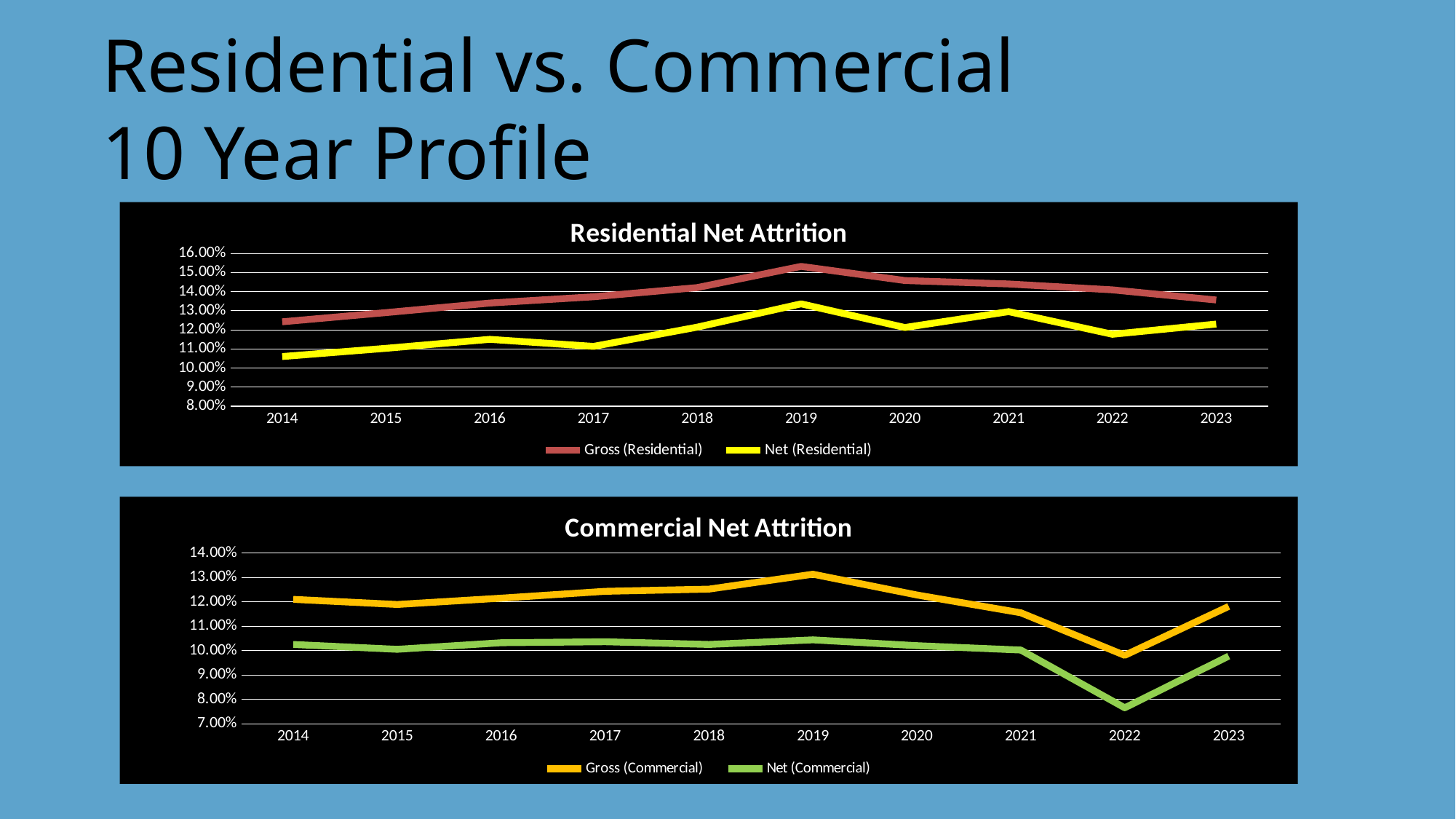
In the Commercial Net Attrition chart, which series is higher in 2021, Gross (Commercial) or Net (Commercial)? Gross (Commercial) How many years are plotted on the x axis of the Residential Net Attrition chart? 10 How many series does the legend of the Commercial Net Attrition chart list? 2 In the Commercial Net Attrition chart, in which year is Net (Commercial) lowest? 2022 In the Residential Net Attrition chart, is the Gross (Residential) value for 2019 greater or less than 15.00%? greater In the Residential Net Attrition chart, in which year is Net (Residential) lowest? 2014 In the Commercial Net Attrition chart, is the Net (Commercial) value for 2022 greater or less than 8.00%? less In the Commercial Net Attrition chart, in which year does Gross (Commercial) reach its highest value? 2019 In the Residential Net Attrition chart, in which year does Gross (Residential) reach its highest value? 2019 In the Residential Net Attrition chart, is the Net (Residential) value for 2014 greater or less than 11.00%? less What kind of chart is the Residential Net Attrition chart? line chart